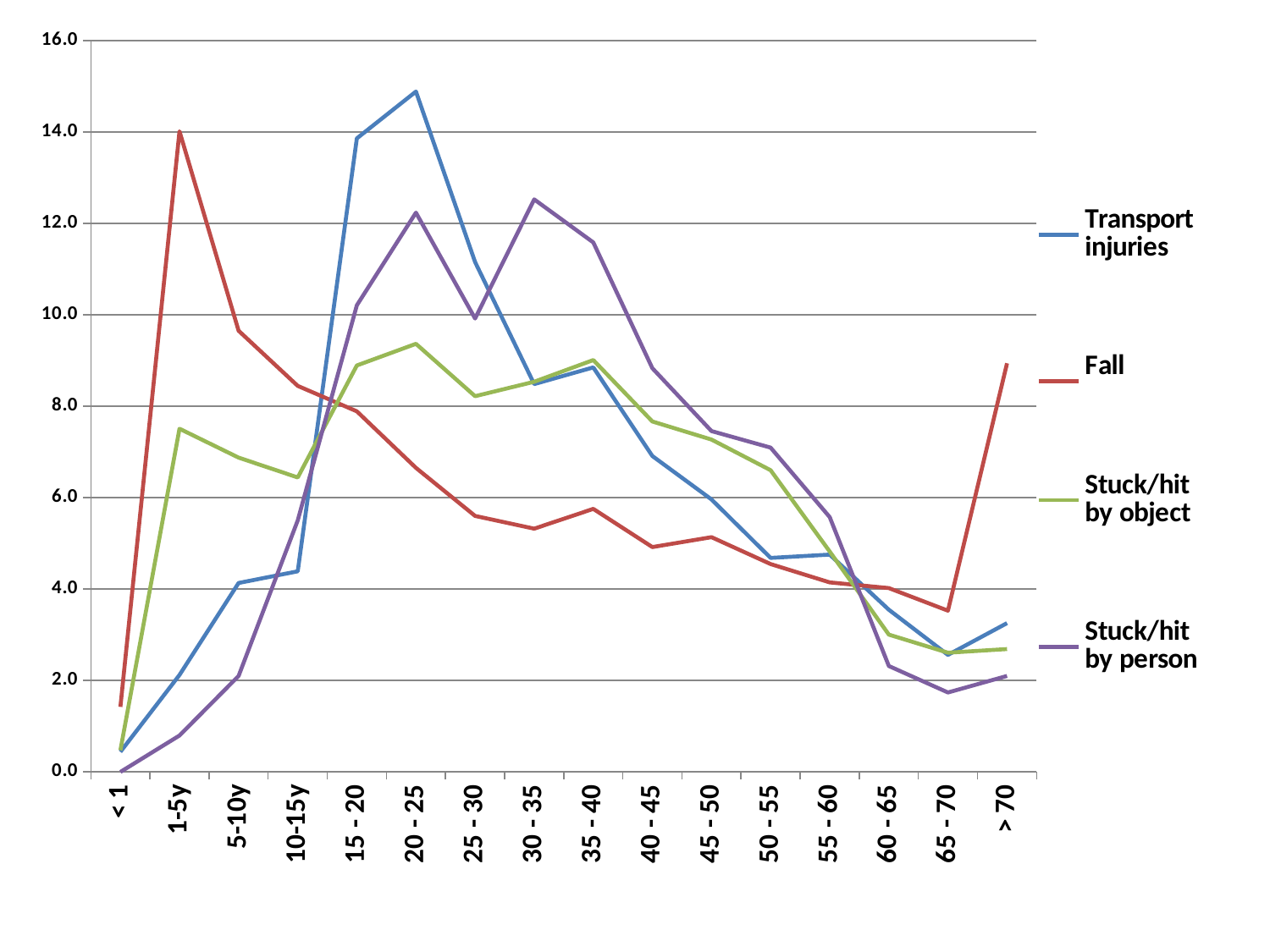
In which age category does the Fall line reach its highest value? 1-5y Is the value for Fall at > 70 greater or less than 8.0? greater How many series does the legend list? 4 Which colour is used for the Stuck/hit by object line? Green In which age category is the Stuck/hit by person line at its lowest? < 1 How many age categories are shown on the x axis? 16 In which age category does the Transport injuries line reach its highest value? 20 - 25 What kind of chart is shown on the slide? Line chart At 1-5y, which series has the larger value, Fall or Transport injuries? Fall Is the value for Stuck/hit by object at 1-5y greater or less than 6.0? greater Is the value for Transport injuries at 20 - 25 greater or less than 14.0? greater In which age category does the Stuck/hit by person line reach its highest value? 30 - 35